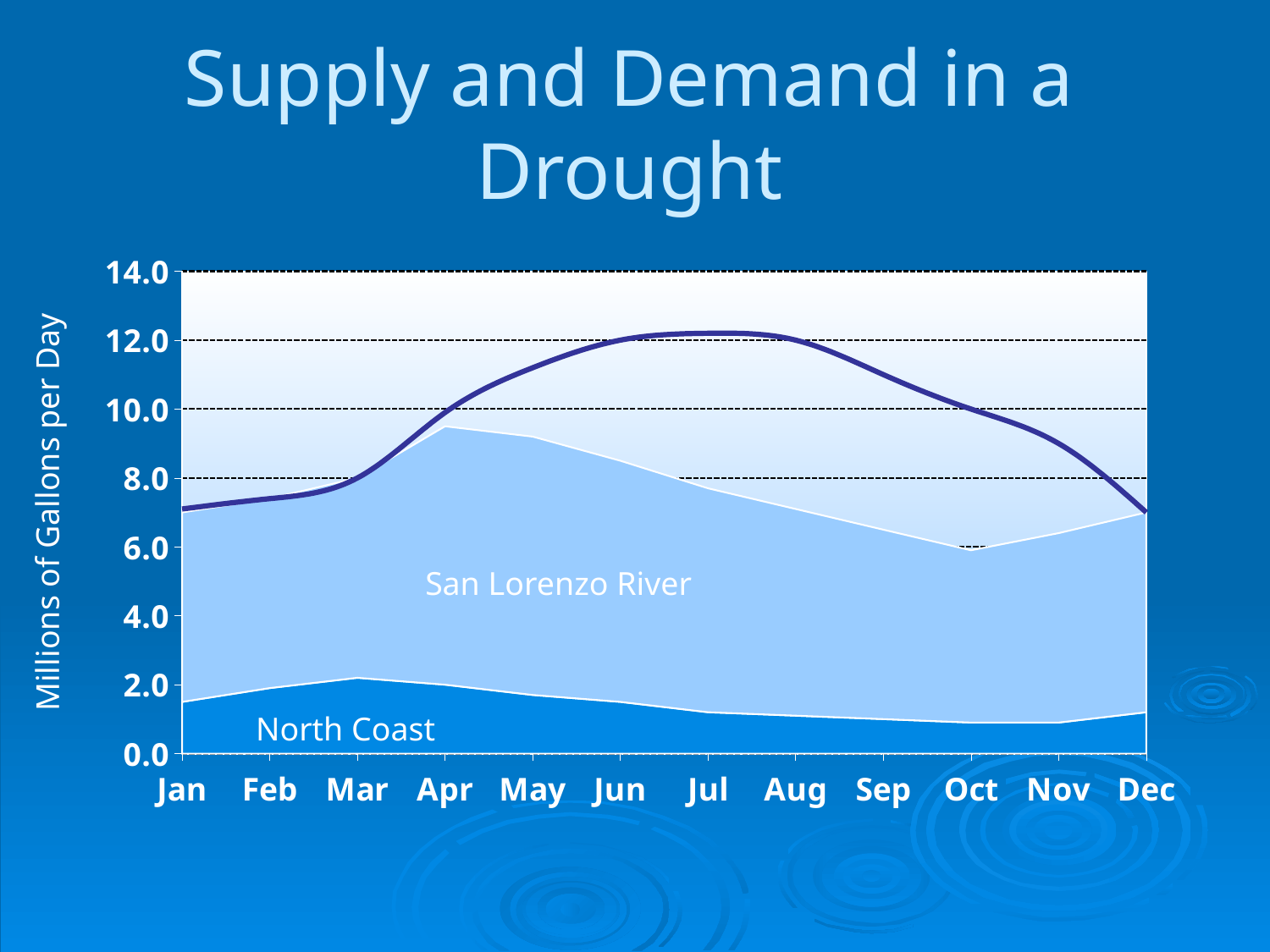
What is the title of the slide's chart? Supply and Demand in a Drought How many months are shown along the x axis of the chart? 12 In which month is the top of the stacked supply area (San Lorenzo River plus North Coast) at its lowest? Oct In which month is the North Coast area at its highest? Mar Is the value of the dark demand line in Jan greater or less than 8.0? less Does the dark demand line rise or fall from Jul to Dec? fall What is the label on the vertical axis of the chart? Millions of Gallons per Day Is the North Coast value in Jul greater or less than 2.0? less In which month does the dark demand line reach its highest value? Jul Is the top of the stacked supply area in Apr greater or less than 8.0? greater What kind of chart is shown on the slide? combination area and line chart